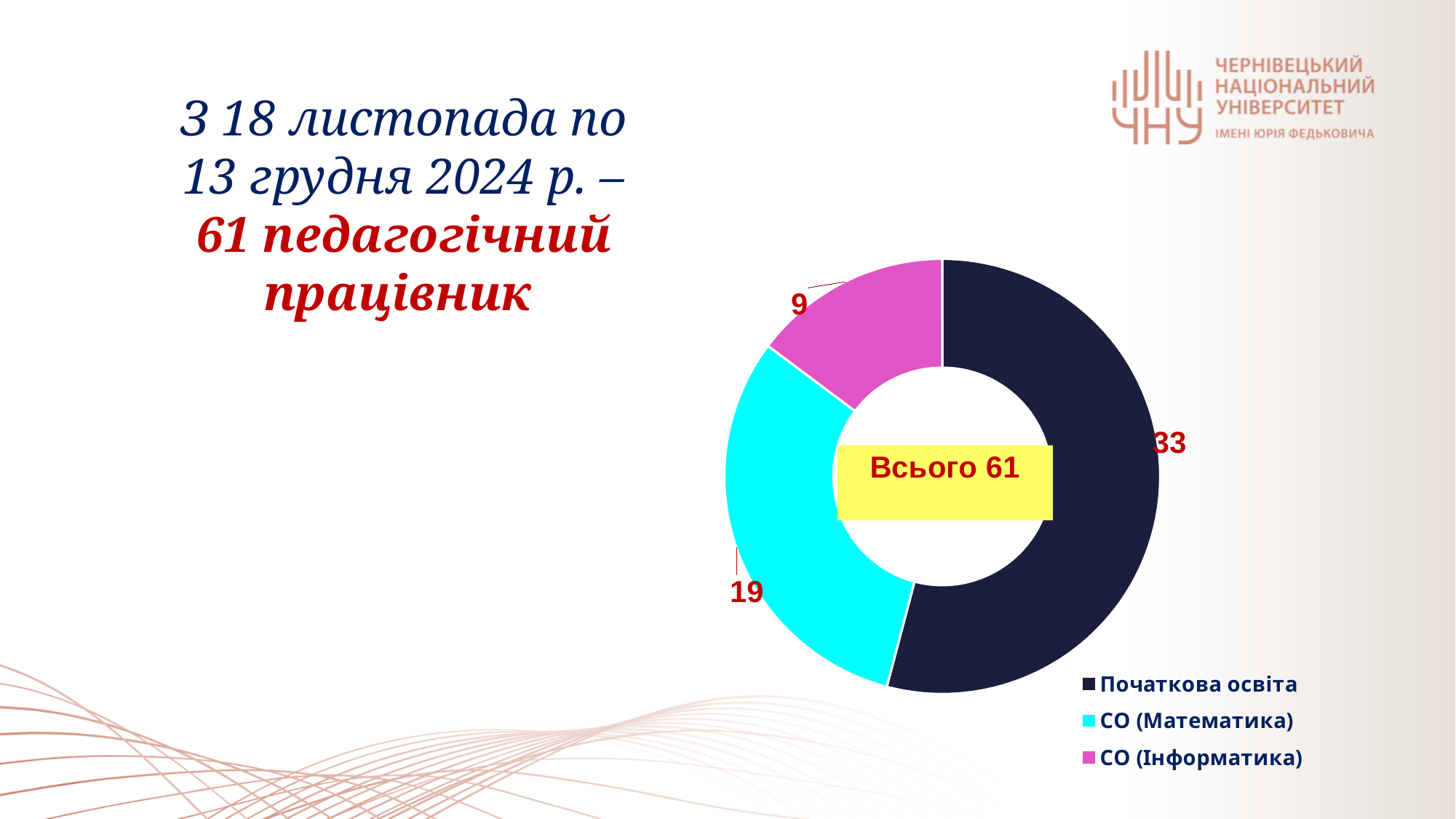
What colour is the segment for СО (Інформатика)? Magenta (pink) What value is shown for СО (Інформатика)? 9 How many categories does the chart show? 3 What kind of chart is shown on the slide? Doughnut (pie) chart Which is larger, the value for СО (Математика) or the value for СО (Інформатика)? СО (Математика) What is the difference between the values for СО (Математика) and СО (Інформатика)? 10 Which category has the largest value? Початкова освіта What is the difference between the values for Початкова освіта and СО (Математика)? 14 Which category has the smallest value? СО (Інформатика) What value is shown for Початкова освіта? 33 What value is shown for СО (Математика)? 19 What total is shown in the centre of the chart? Всього 61